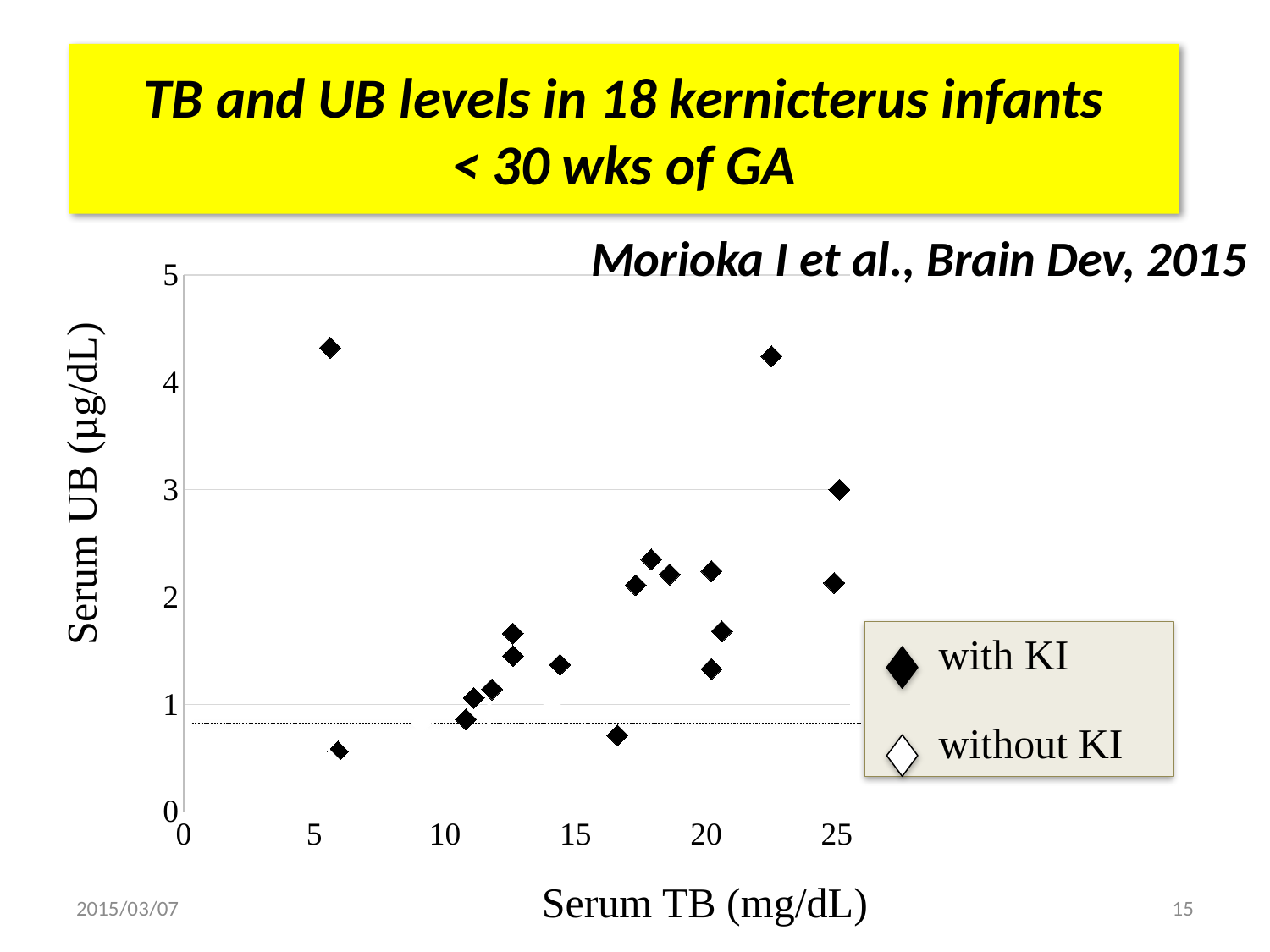
Is the Serum UB value of the lowest plotted point greater or less than 1? less What is the label of the x axis? Serum TB (mg/dL) Is the Serum UB value of the highest plotted point greater or less than 4? greater How many series does the legend list? 2 What kind of chart is shown on the slide? scatter plot Is the Serum TB value of the leftmost plotted points greater or less than 10? less How many data points are plotted on the chart? 18 Are all the plotted points from the 'with KI' series or the 'without KI' series? with KI What is the maximum value shown on the y axis? 5 What are the two series named in the legend? with KI, without KI